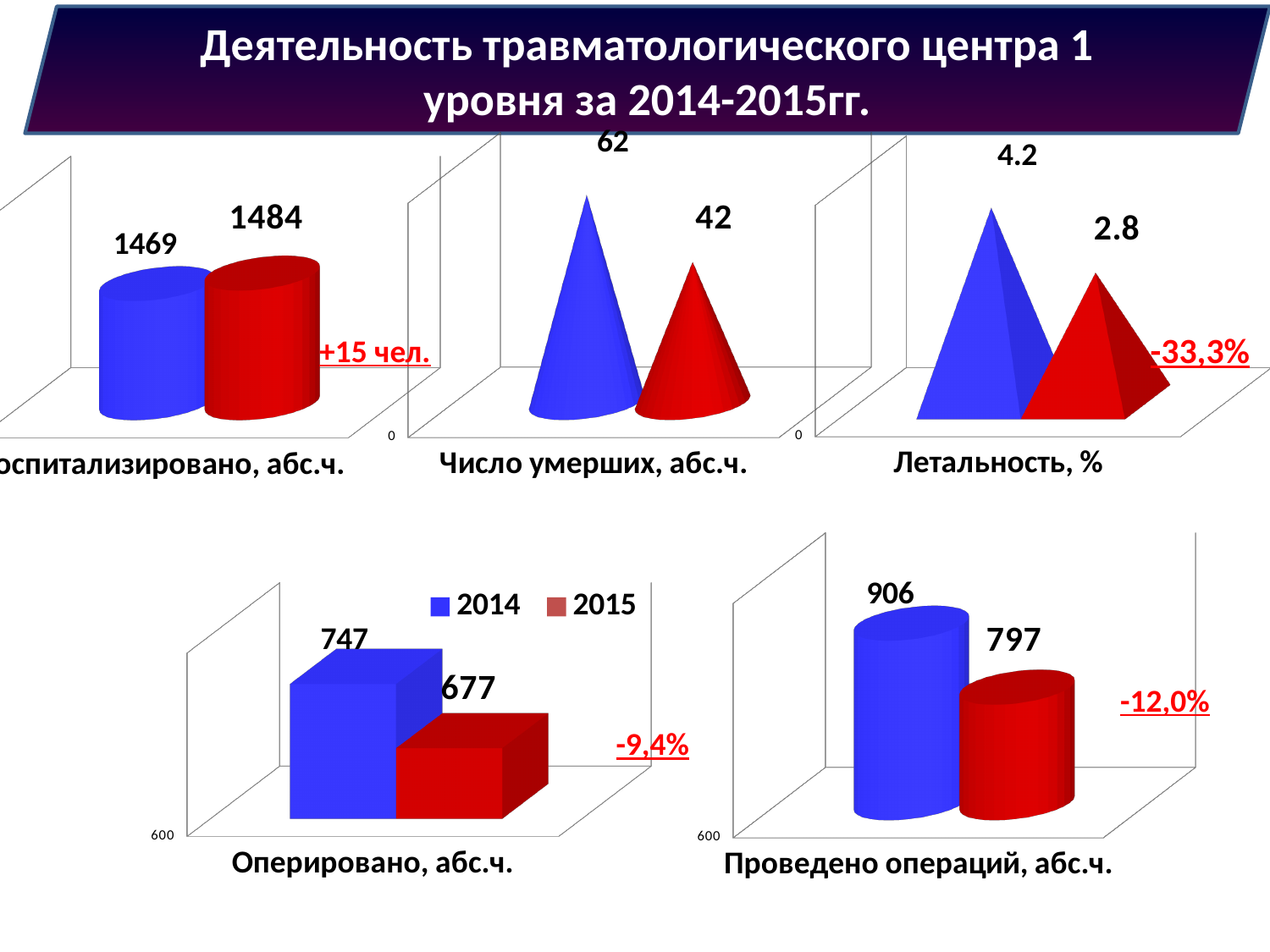
In the chart titled 'Проведено операций, абс.ч.', what is the value for 2014? 906 In the chart titled 'Летальность, %', which year has the higher value, 2014 or 2015? 2014 How many series does the legend on the slide list? 2 In the chart titled 'Проведено операций, абс.ч.', which year has the lower value? 2015 What colour represents 2015 in the legend? Red In the chart titled 'Число умерших, абс.ч.', what is the difference between the 2014 and 2015 values? 20 In the top-left chart (hospitalised, абс.ч.), what is the value for 2015? 1484 In the chart titled 'Оперировано, абс.ч.', what is the value for 2015? 677 In the chart titled 'Число умерших, абс.ч.', what is the value for 2014? 62 In the top-left chart (hospitalised, абс.ч.), what is the value for 2014? 1469 In the chart titled 'Оперировано, абс.ч.', what is the difference between the 2014 and 2015 values? 70 In the chart titled 'Летальность, %', what is the value for 2015? 2.8